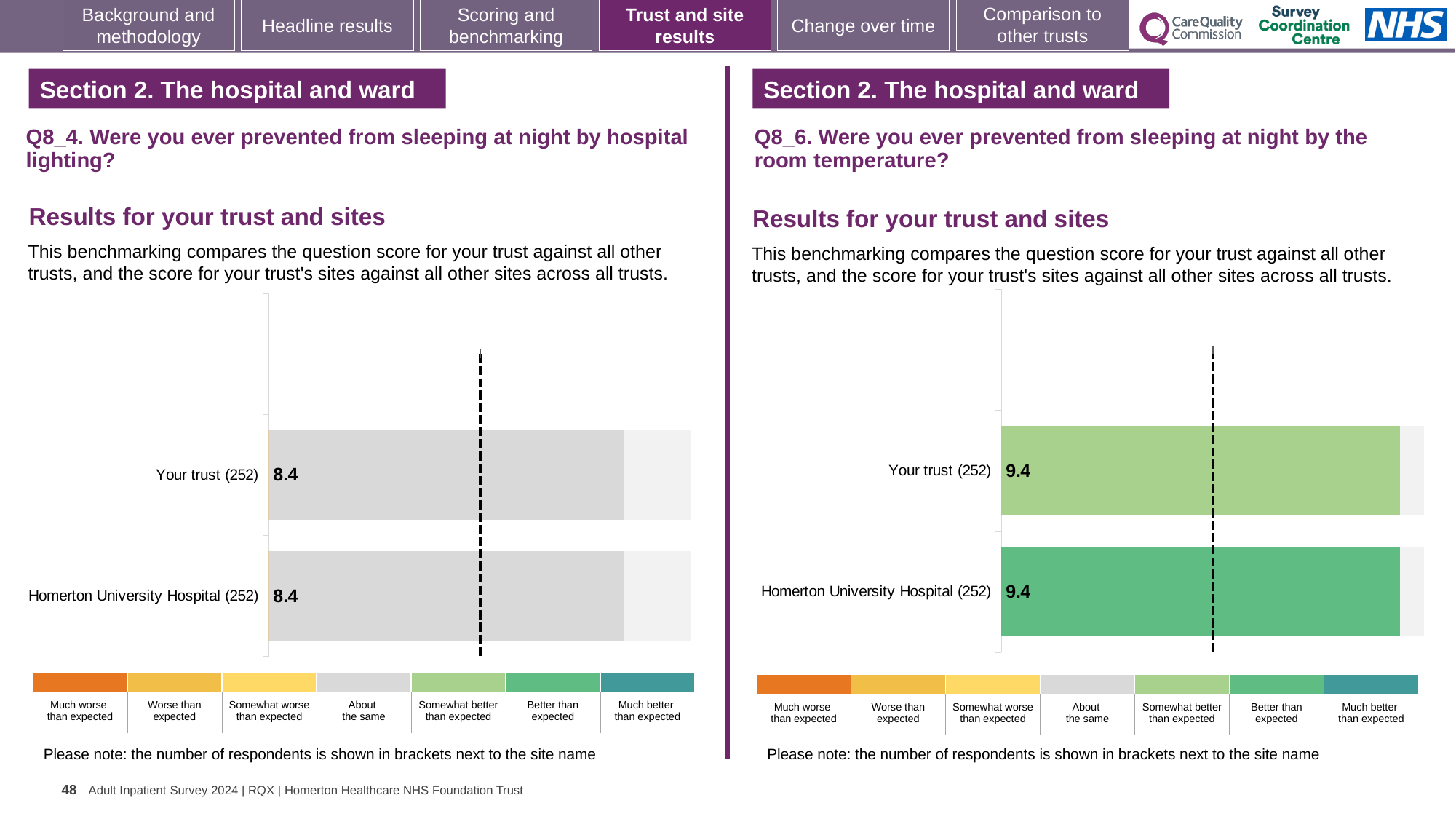
On the Q8_6 room temperature chart, what is the difference between the Your trust score and the Homerton University Hospital score? 0 On the Q8_4 hospital lighting chart, how many bars are plotted? 2 What kind of chart is used on the Q8_4 hospital lighting chart? Bar chart How many respondents are shown in brackets for Your trust on the Q8_6 room temperature chart? 252 On the Q8_6 room temperature chart, what is the score for Homerton University Hospital (252)? 9.4 On the Q8_4 hospital lighting chart, what is the score for Your trust (252)? 8.4 On the Q8_6 room temperature chart, which benchmark category does the colour of the Homerton University Hospital bar correspond to? Better than expected Is the Your trust score on the Q8_6 room temperature chart larger or smaller than the Your trust score on the Q8_4 hospital lighting chart? Larger On the Q8_4 hospital lighting chart, which benchmark category does the colour of the Your trust bar correspond to? About the same On the Q8_6 room temperature chart, how many bars are plotted? 2 On the Q8_4 hospital lighting chart, what is the score for Homerton University Hospital (252)? 8.4 On the Q8_6 room temperature chart, what is the score for Your trust (252)? 9.4